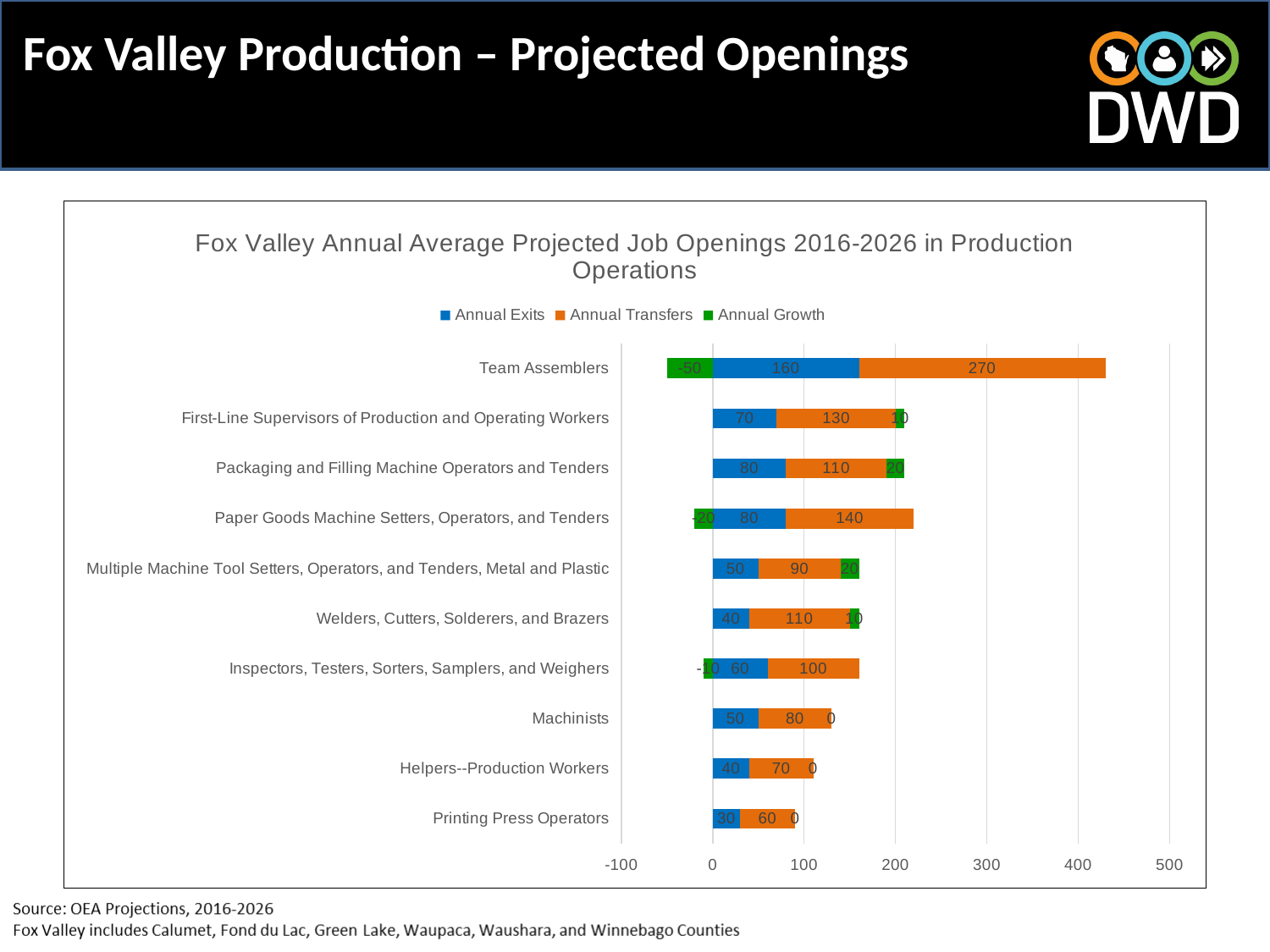
What is the Annual Transfers value for Welders, Cutters, Solderers, and Brazers? 110 How many series does the legend list? 3 What kind of chart is shown on the slide? Stacked bar chart What is the Annual Transfers value for Team Assemblers? 270 What is the Annual Exits value for Paper Goods Machine Setters, Operators, and Tenders? 80 Which occupation has the highest Annual Transfers value? Team Assemblers What is the Annual Growth value for Team Assemblers? -50 What is the difference between Annual Transfers and Annual Exits for Team Assemblers? 110 Which occupation has the lowest Annual Exits value? Printing Press Operators How many occupations are shown in the chart? 10 What is the total of the stacked bar for Packaging and Filling Machine Operators and Tenders? 210 Which has a larger Annual Transfers value: Paper Goods Machine Setters, Operators, and Tenders or Packaging and Filling Machine Operators and Tenders? Paper Goods Machine Setters, Operators, and Tenders